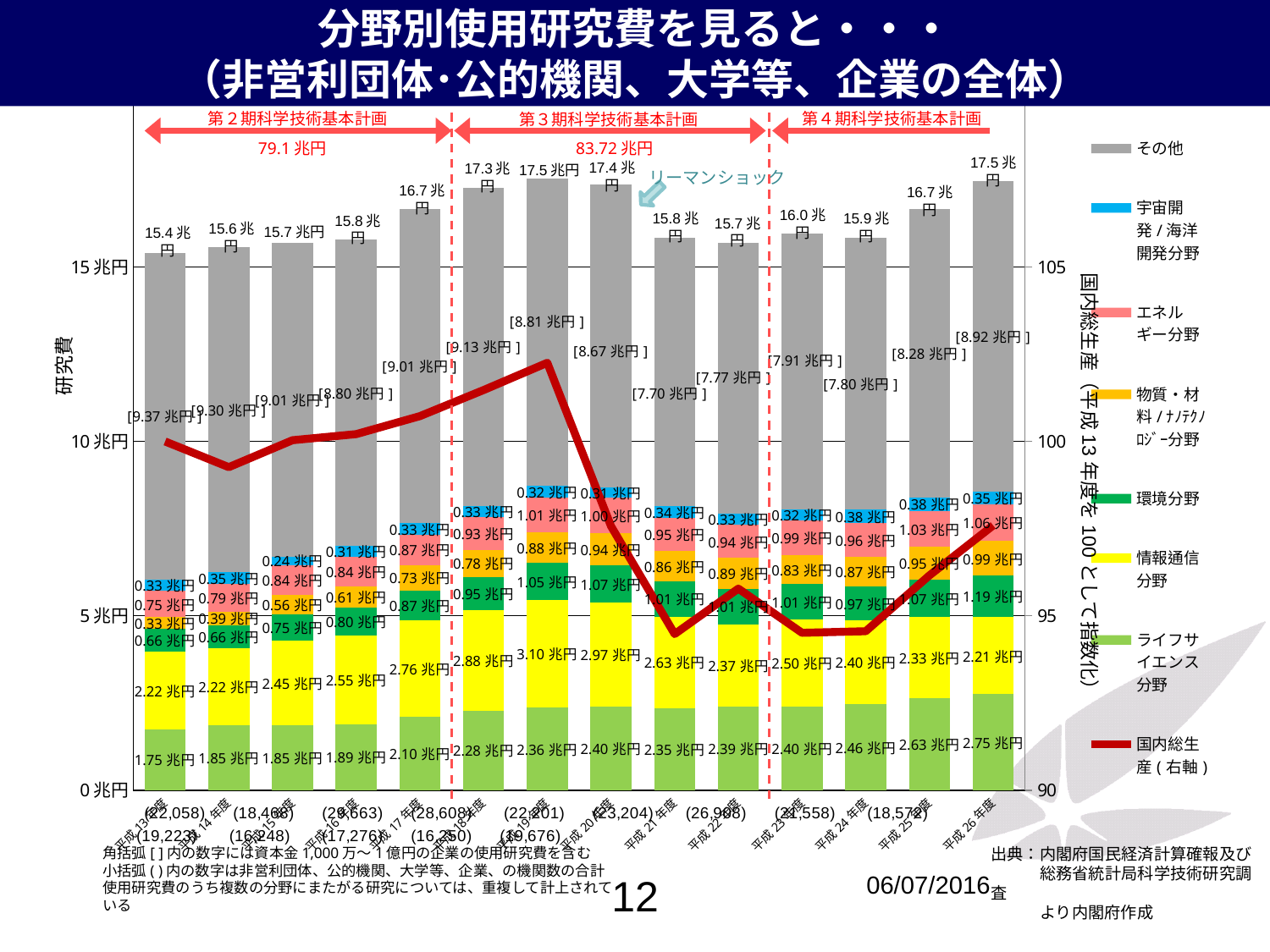
How many series does the legend list? 8 What kind of chart is shown on the slide? bar chart (stacked bars with a line) Which fiscal year has the highest value for ライフサイエンス分野? 平成26年度 What is the total research expenditure shown above the bar for 平成17年度? 16.7兆円 What is the difference between the ライフサイエンス分野 values for 平成26年度 and 平成13年度? 1.00兆円 What is the total research expenditure shown above the bar for 平成13年度? 15.4兆円 How many fiscal years (bars) are plotted on the chart? 14 What is the value of ライフサイエンス分野 for 平成26年度? 2.75兆円 Which fiscal year has the lowest total research expenditure? 平成13年度 What is the value of 情報通信分野 for 平成19年度? 3.10兆円 Which is larger, the 情報通信分野 value for 平成19年度 or for 平成26年度? 平成19年度 Do the ライフサイエンス分野 values generally rise or fall from 平成13年度 to 平成26年度? rise